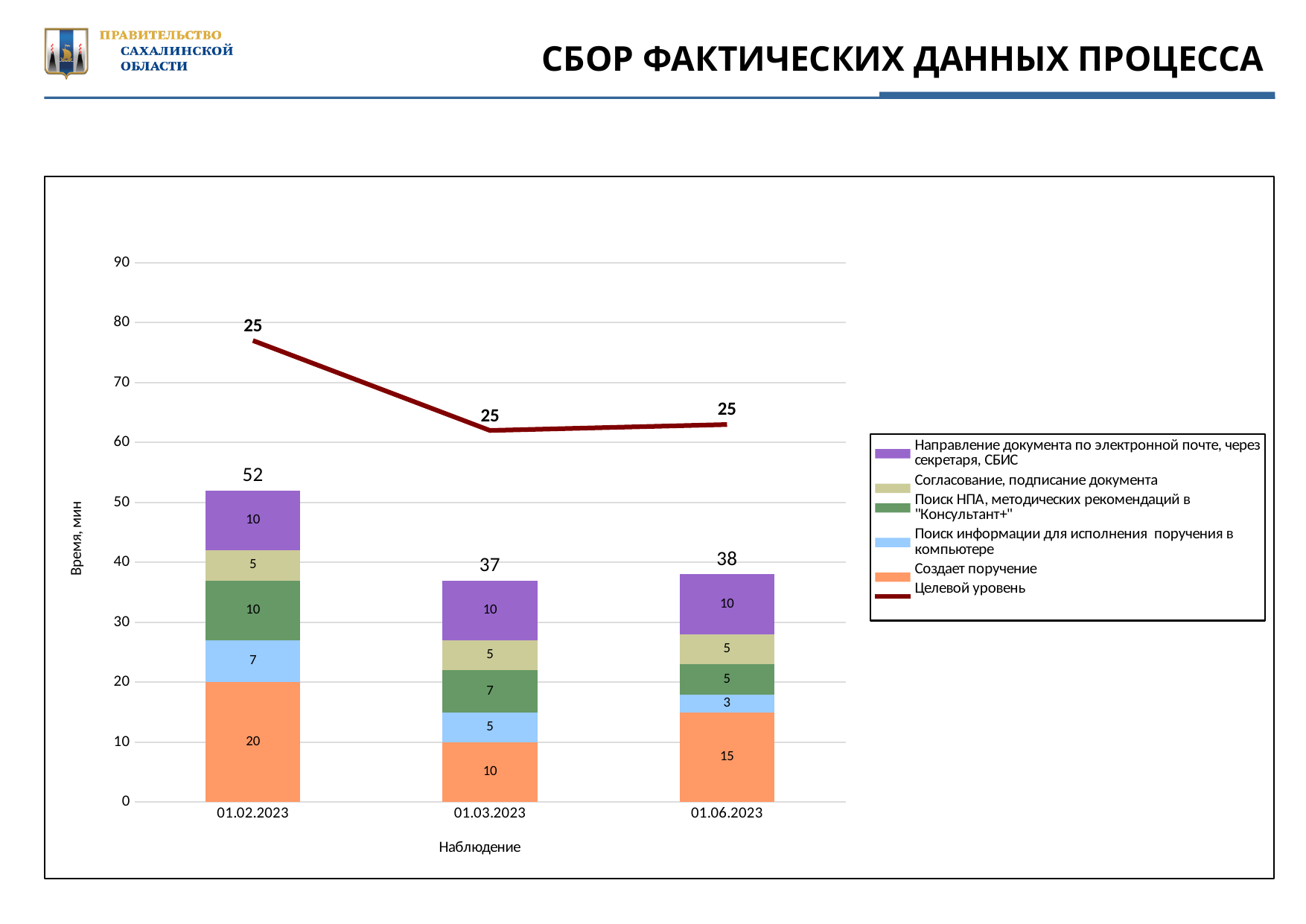
Is the "Создает поручение" segment larger for 01.02.2023 or for 01.06.2023? 01.02.2023 What is the value of the "Поиск НПА, методических рекомендаций в "Консультант+"" segment for 01.02.2023? 10 How many entries does the legend list? 6 What is the value of the "Создает поручение" segment for 01.03.2023? 10 What is the label of the y axis? Время, мин What is the total of the stacked bar for 01.02.2023? 52 Which observation date has the lowest stacked bar total? 01.03.2023 How many observation dates are shown on the x axis? 3 Which observation date has the highest stacked bar total? 01.02.2023 What is the value of the "Поиск информации для исполнения поручения в компьютере" segment for 01.06.2023? 3 What is the data label on the "Целевой уровень" line at 01.03.2023? 25 What is the difference between the stacked bar totals for 01.02.2023 and 01.06.2023? 14